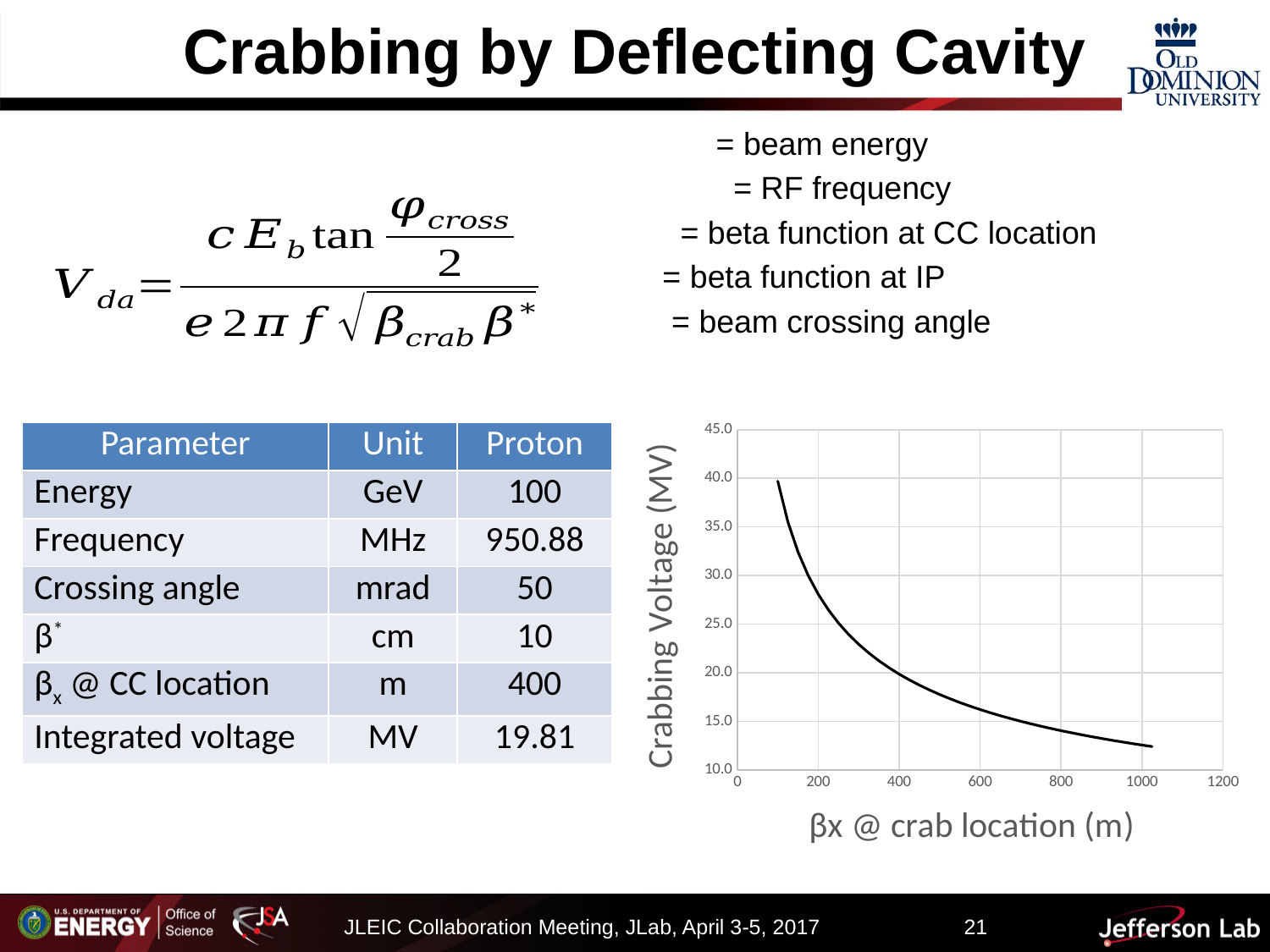
Is the crabbing voltage at βx = 1000 m greater or less than 15.0 MV? less Is the crabbing voltage at βx = 400 m greater or less than 25.0 MV? less Which has the higher crabbing voltage: βx = 200 m or βx = 800 m? 200 m Is the crabbing voltage at βx = 200 m greater or less than 35.0 MV? less What is the label of the y axis of the chart? Crabbing Voltage (MV) What kind of chart is shown on the slide? line chart Does the crabbing voltage rise or fall as βx @ crab location increases? fall What is the label of the x axis of the chart? βx @ crab location (m)